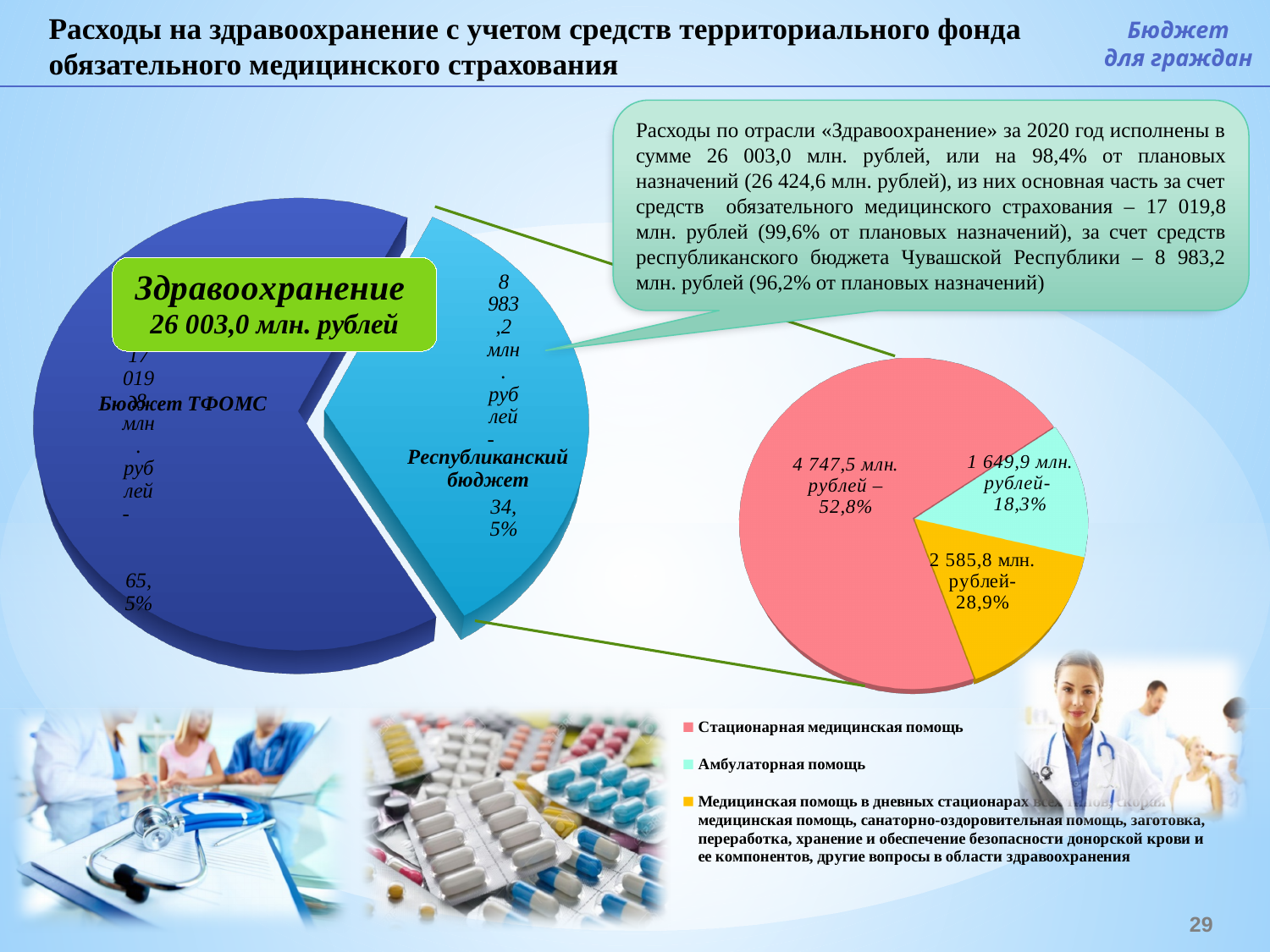
On the right pie chart, what is the value for Амбулаторная помощь in млн. рублей? 1 649,9 млн. рублей On the right pie chart, what share does the yellow slice (Медицинская помощь в дневных стационарах...) account for? 28,9% What total value is shown in the green box over the left pie chart for Здравоохранение? 26 003,0 млн. рублей On the left pie chart, which slice is larger, Бюджет ТФОМС or Республиканский бюджет? Бюджет ТФОМС On the left pie chart, what is the value shown for Республиканский бюджет in млн. рублей? 8 983,2 млн. рублей How many slices does the left pie chart have? 2 On the left pie chart, what share does Республиканский бюджет account for? 34,5% On the right pie chart, what is the difference in percentage points between Стационарная медицинская помощь and Амбулаторная помощь? 34,5 On the right pie chart, what share does Стационарная медицинская помощь account for? 52,8% On the right pie chart, which category has the smallest share? Амбулаторная помощь What type of chart is the right chart? Pie chart On the left pie chart, what share does Бюджет ТФОМС account for? 65,5%